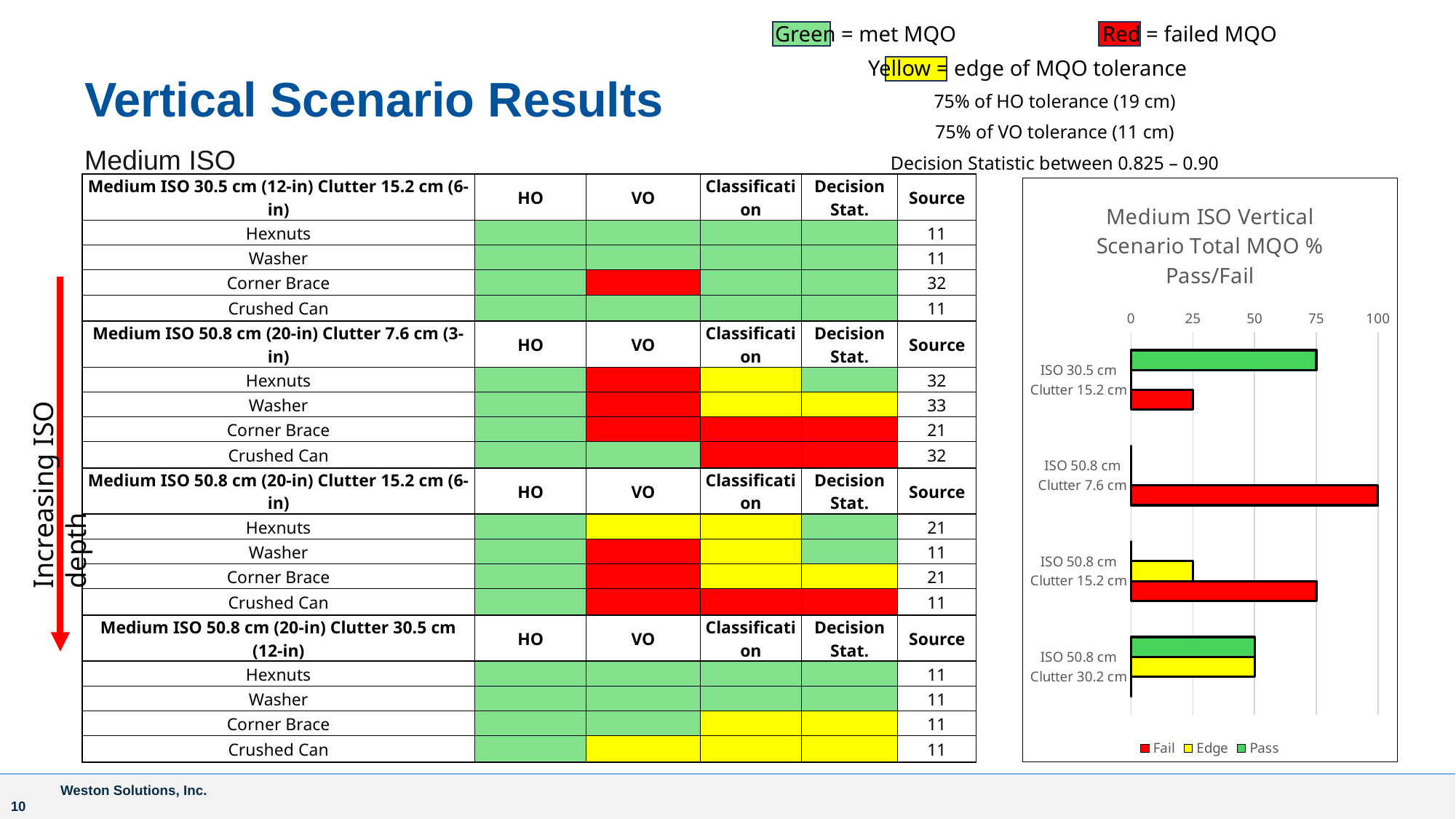
What colour represents the Edge series in the chart legend? yellow For ISO 50.8 cm Clutter 15.2 cm, which is larger, the Fail value or the Edge value? Fail Which category has the larger Pass value, ISO 30.5 cm Clutter 15.2 cm or ISO 50.8 cm Clutter 30.2 cm? ISO 30.5 cm Clutter 15.2 cm How many series does the legend of the chart list? 3 Is the Pass value for ISO 30.5 cm Clutter 15.2 cm greater or less than 50? greater Is the Edge value for ISO 50.8 cm Clutter 15.2 cm greater or less than 50? less How many categories are plotted on the chart? 4 What is the title of the chart? Medium ISO Vertical Scenario Total MQO % Pass/Fail Which category has the highest Fail value? ISO 50.8 cm Clutter 7.6 cm Is the Fail value for ISO 30.5 cm Clutter 15.2 cm greater or less than 50? less What is the Fail value for ISO 50.8 cm Clutter 7.6 cm? 100 What kind of chart is shown on the slide? bar chart